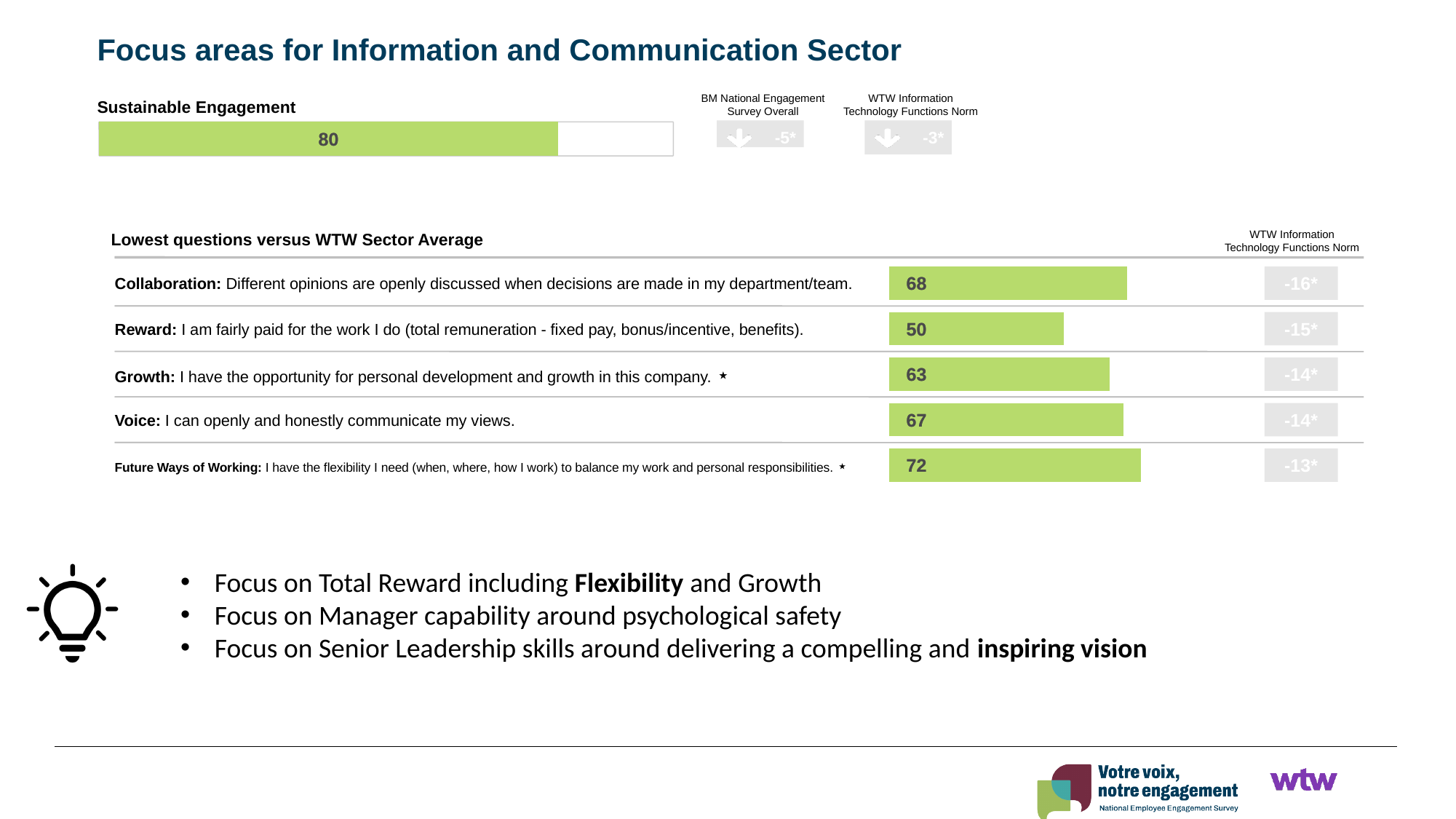
In the Lowest questions versus WTW Sector Average chart, which has a higher score, Growth or Voice? Voice In the Sustainable Engagement chart, what is the difference shown versus the BM National Engagement Survey Overall? -5* In the Lowest questions versus WTW Sector Average chart, what is the value for Reward? 50 In the Lowest questions versus WTW Sector Average chart, what is the WTW Information Technology Functions Norm difference shown for Collaboration? -16* In the Sustainable Engagement chart, what is the difference shown versus the WTW Information Technology Functions Norm? -3* In the Lowest questions versus WTW Sector Average chart, how many questions are shown? 5 In the Lowest questions versus WTW Sector Average chart, what is the value for Future Ways of Working? 72 In the Lowest questions versus WTW Sector Average chart, which question has the lowest score? Reward In the Sustainable Engagement chart, what is the Sustainable Engagement score shown on the bar? 80 In the Lowest questions versus WTW Sector Average chart, what is the difference between the Collaboration score and the Reward score? 18 In the Lowest questions versus WTW Sector Average chart, which question has the highest score? Future Ways of Working What kind of chart is used to show the scores in the Lowest questions versus WTW Sector Average section? Bar chart